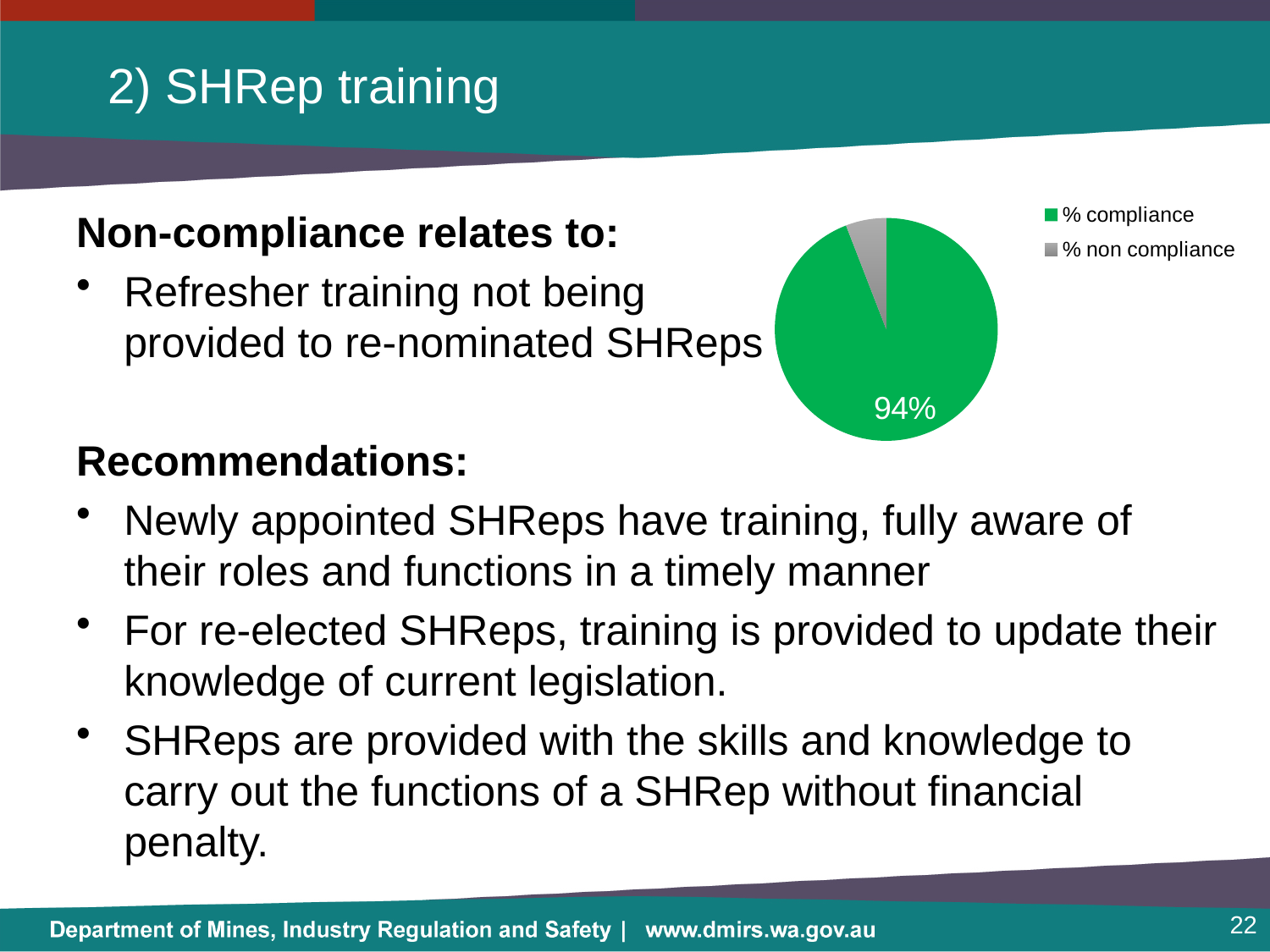
Is the value for % compliance greater or less than 50%? greater Which slice of the pie chart is the smallest? % non compliance What colour is the % non compliance slice in the pie chart? grey How many slices does the pie chart have? 2 What share of the pie does the % compliance slice take? 94% Which slice of the pie chart is the largest? % compliance What kind of chart is shown on the slide? pie chart What percentage is shown for the % compliance slice of the pie chart? 94% What colour is the % compliance slice in the pie chart? green How many entries does the pie chart's legend list? 2 Which is larger in the pie chart, % compliance or % non compliance? % compliance